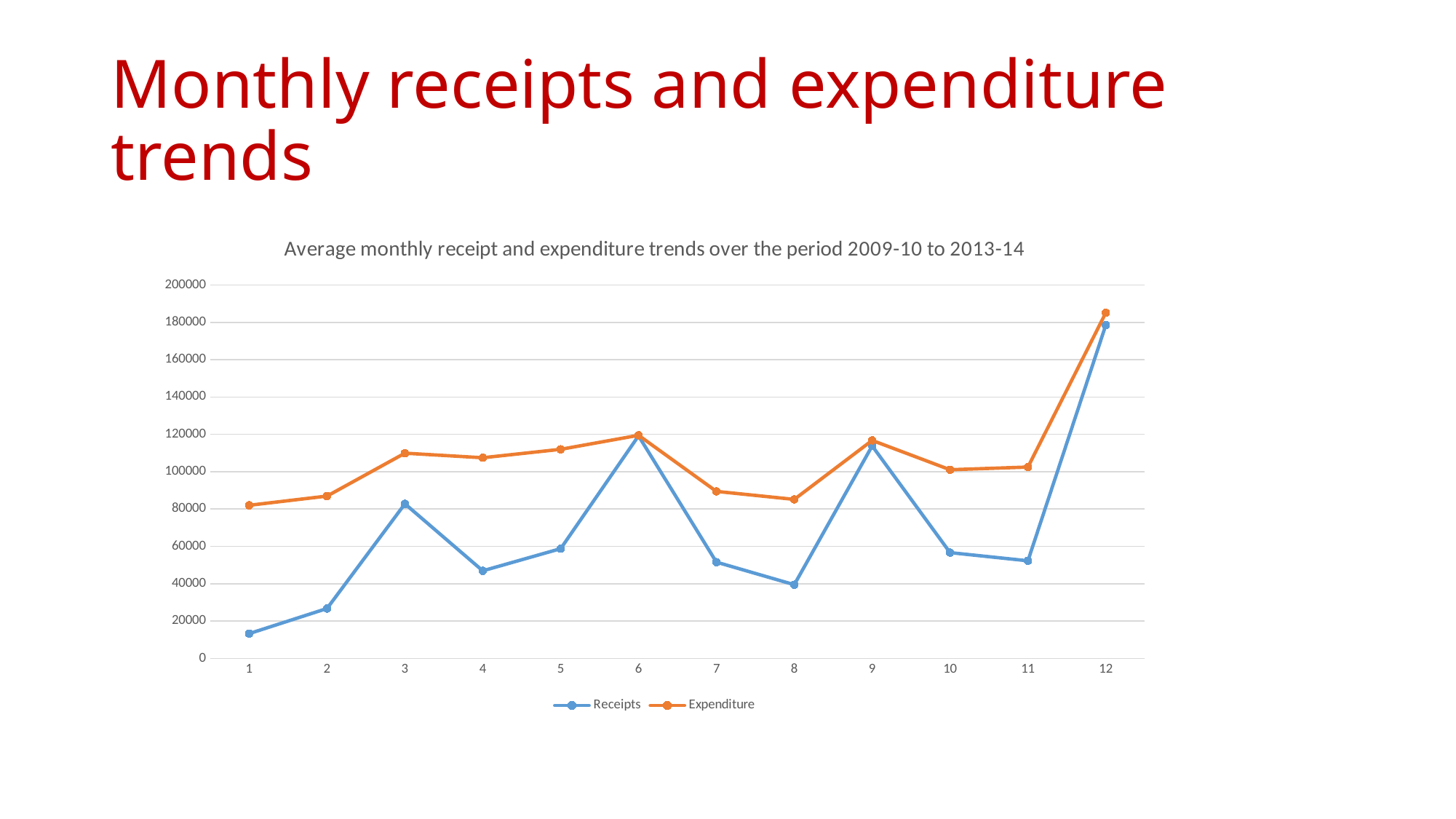
What kind of chart is shown on the slide? line chart Do the Receipts values rise or fall from point 6 to point 8? fall At which x-axis point is the Receipts value highest? 12 At which x-axis point is the Receipts value lowest? 1 Is the Expenditure value at point 6 greater or less than 100000? greater At point 3, which series has the larger value, Receipts or Expenditure? Expenditure Is the Receipts value at point 1 greater or less than 20000? less At which x-axis point is the Expenditure value highest? 12 Is the Expenditure value at point 8 greater or less than 100000? less How many series does the legend list? 2 What colour is the Expenditure line? orange How many points are plotted along the x axis for each series? 12